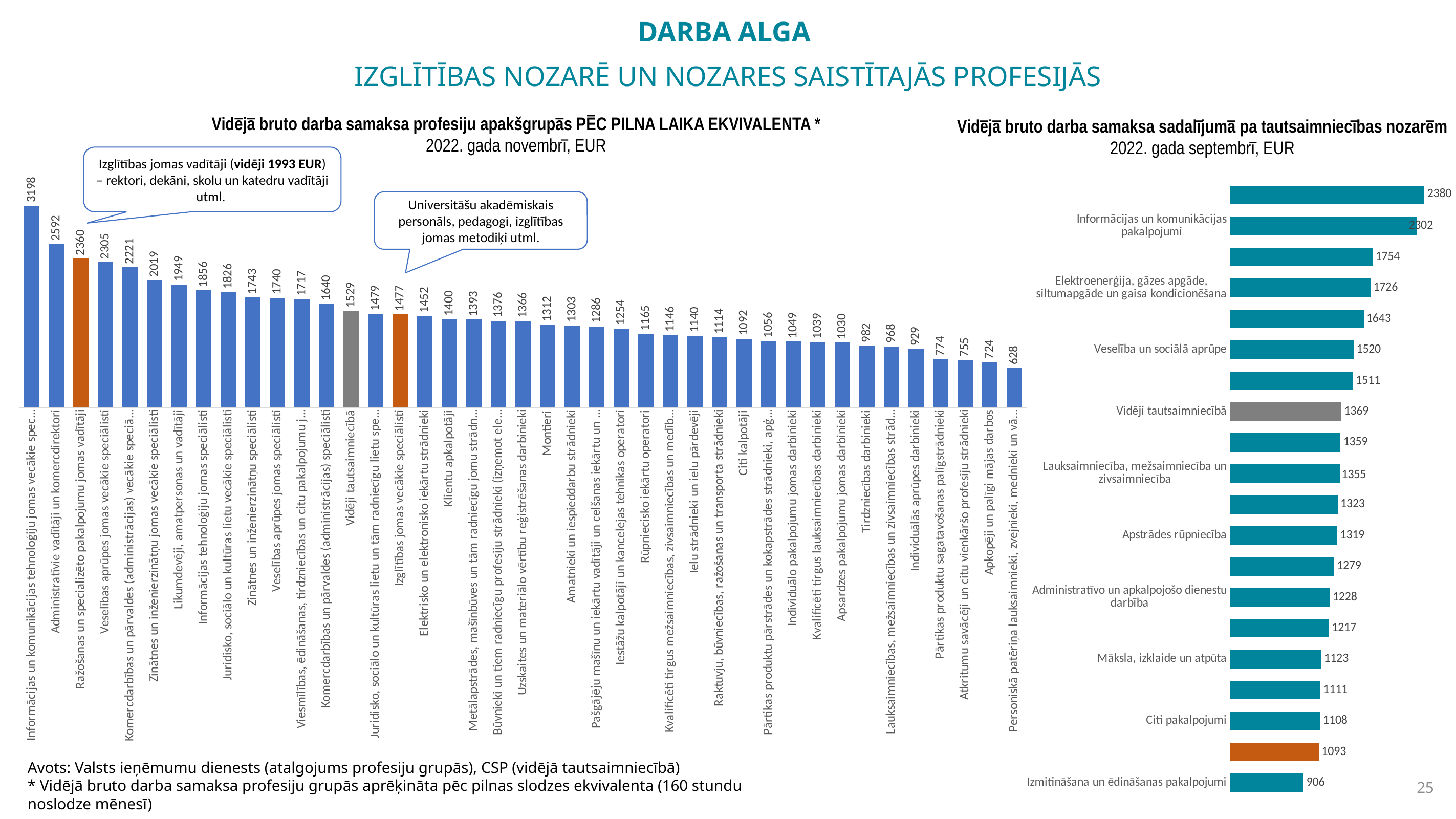
In the right chart, what is the value for Izmitināšana un ēdināšanas pakalpojumi? 906 In the right chart, what is the value for Vidēji tautsaimniecībā? 1369 In the right chart, what is the highest value shown? 2380 In the left chart, what is the difference between Administratīvie vadītāji un komercdirektori and Likumdevēji, amatpersonas un vadītāji? 643 In the right chart, what is the difference between Apstrādes rūpniecība and Citi pakalpojumi? 211 In the left chart, which category has the highest value? Informācijas un komunikācijas tehnoloģiju jomas vecākie speciālisti In the left chart, which is larger: Klientu apkalpotāji or Montieri? Klientu apkalpotāji In the left chart, what is the lowest value shown? 628 In the left chart (Vidējā bruto darba samaksa profesiju apakšgrupās), what is the value for Izglītības jomas vecākie speciālisti? 1477 In the right chart (Vidējā bruto darba samaksa sadalījumā pa tautsaimniecības nozarēm), what is the value for Veselība un sociālā aprūpe? 1520 In the left chart, what is the value for Vidēji tautsaimniecībā? 1529 What kind of chart is the right chart? Bar chart